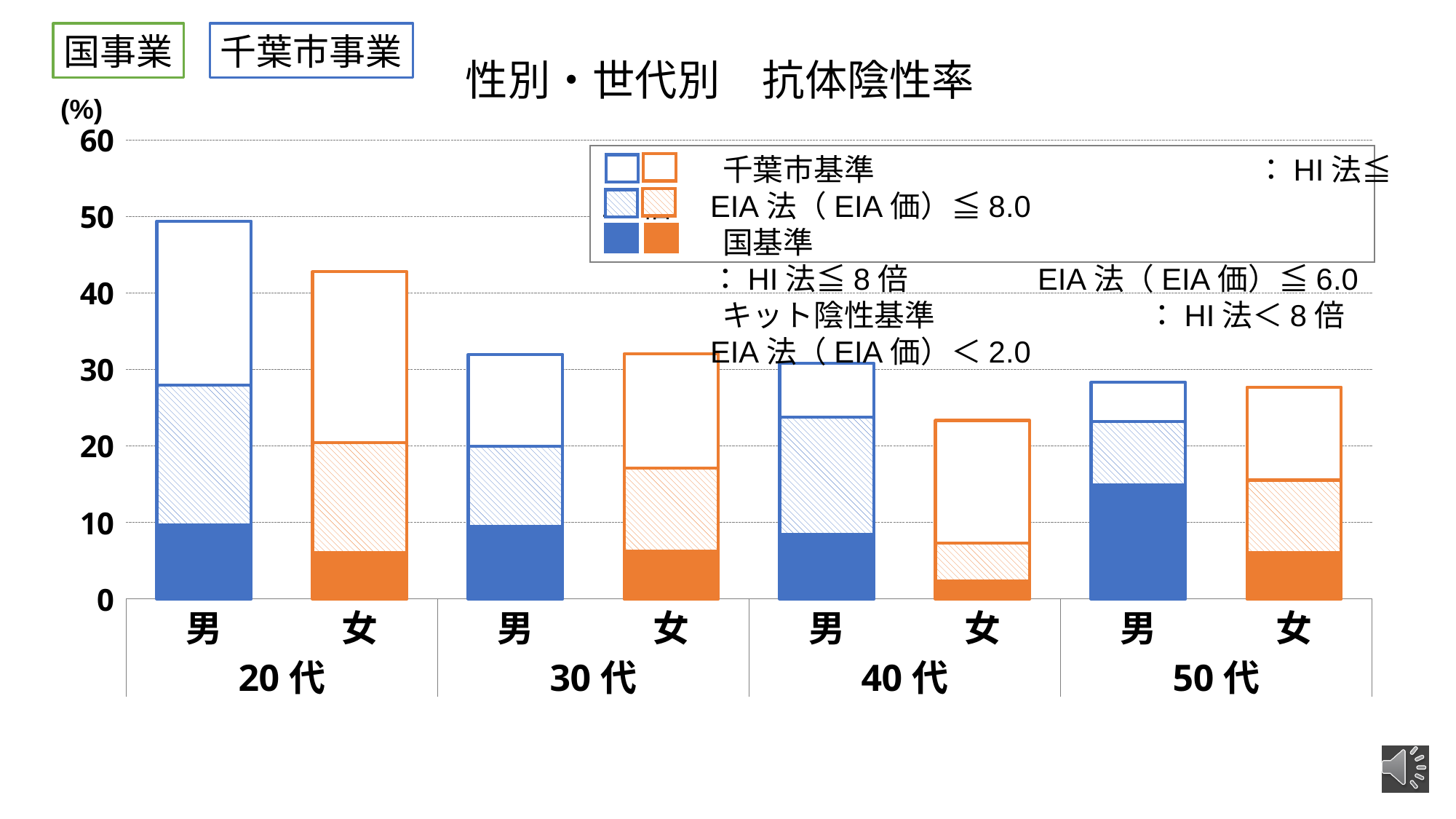
Is the total for 40代 女 greater or less than 30? less Do the total bar heights for 男 rise or fall from 20代 to 50代? fall Is the total for 20代 男 greater or less than 40? greater Is the solid (国基準) segment for 50代 男 greater or less than 10? greater How many bars are plotted in the chart? 8 What kind of chart is shown on the slide? Stacked bar chart Which has the taller total bar, 20代 男 or 20代 女? 20代 男 Which bar reaches the highest total in the chart? 20代 男 What is the title of the chart? 性別・世代別 抗体陰性率 Which colour is used for the 女 bars? Orange Which bar has the lowest total in the chart? 40代 女